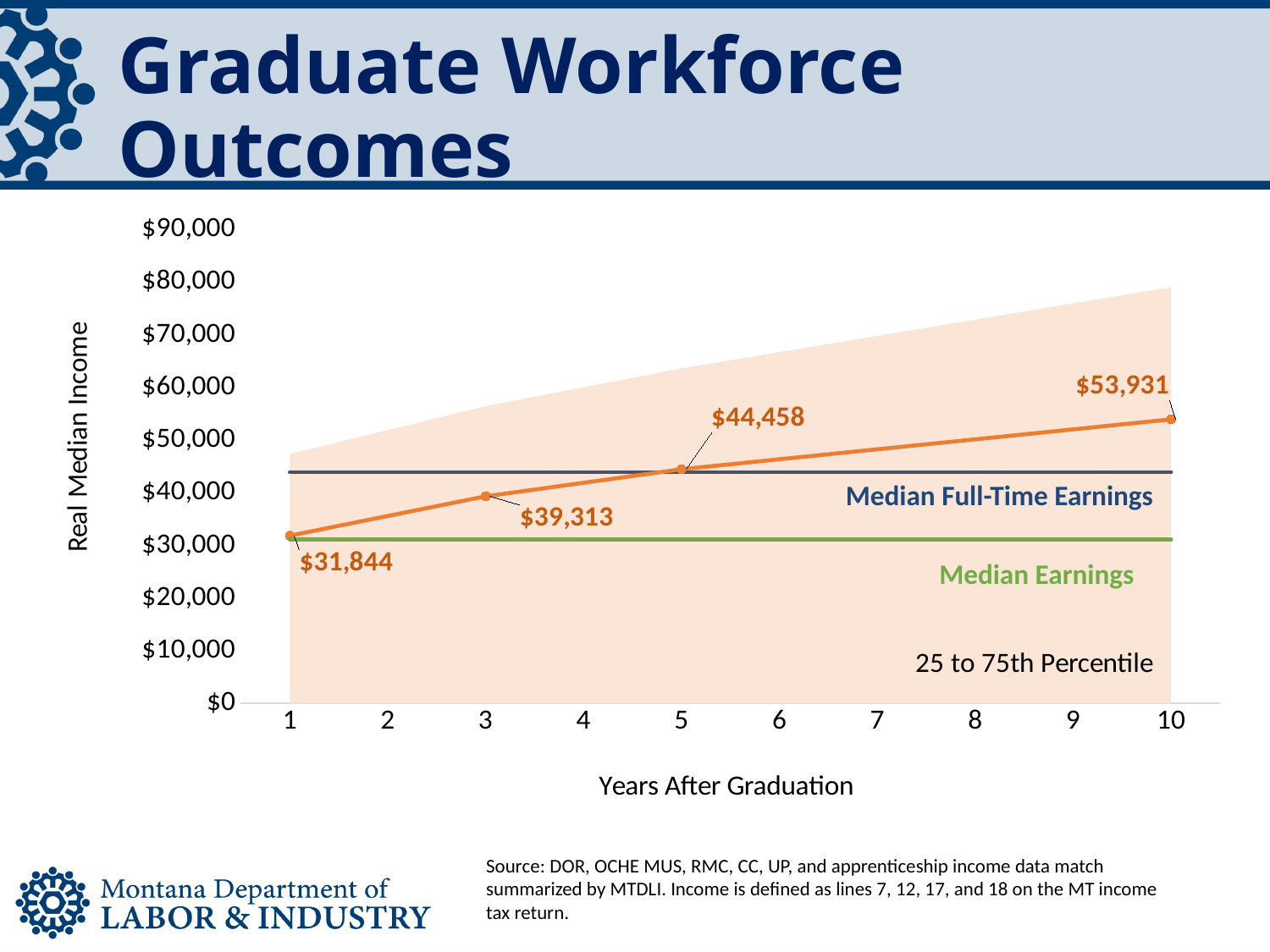
What is the real median income 5 years after graduation? $44,458 What is the difference between the real median income at 5 years and at 3 years after graduation? $5,145 How much higher is the real median income at 10 years after graduation than at 1 year after graduation? $22,087 Does the real median income rise or fall as years after graduation increase? rises What is the real median income 10 years after graduation? $53,931 What is the title of the x axis of the chart? Years After Graduation Is the Median Earnings line greater or less than $40,000? less What is the real median income 1 year after graduation? $31,844 At which number of years after graduation is the labeled real median income lowest? 1 Is the Median Full-Time Earnings line greater or less than $40,000? greater At which number of years after graduation is the labeled real median income highest? 10 What is the real median income 3 years after graduation? $39,313